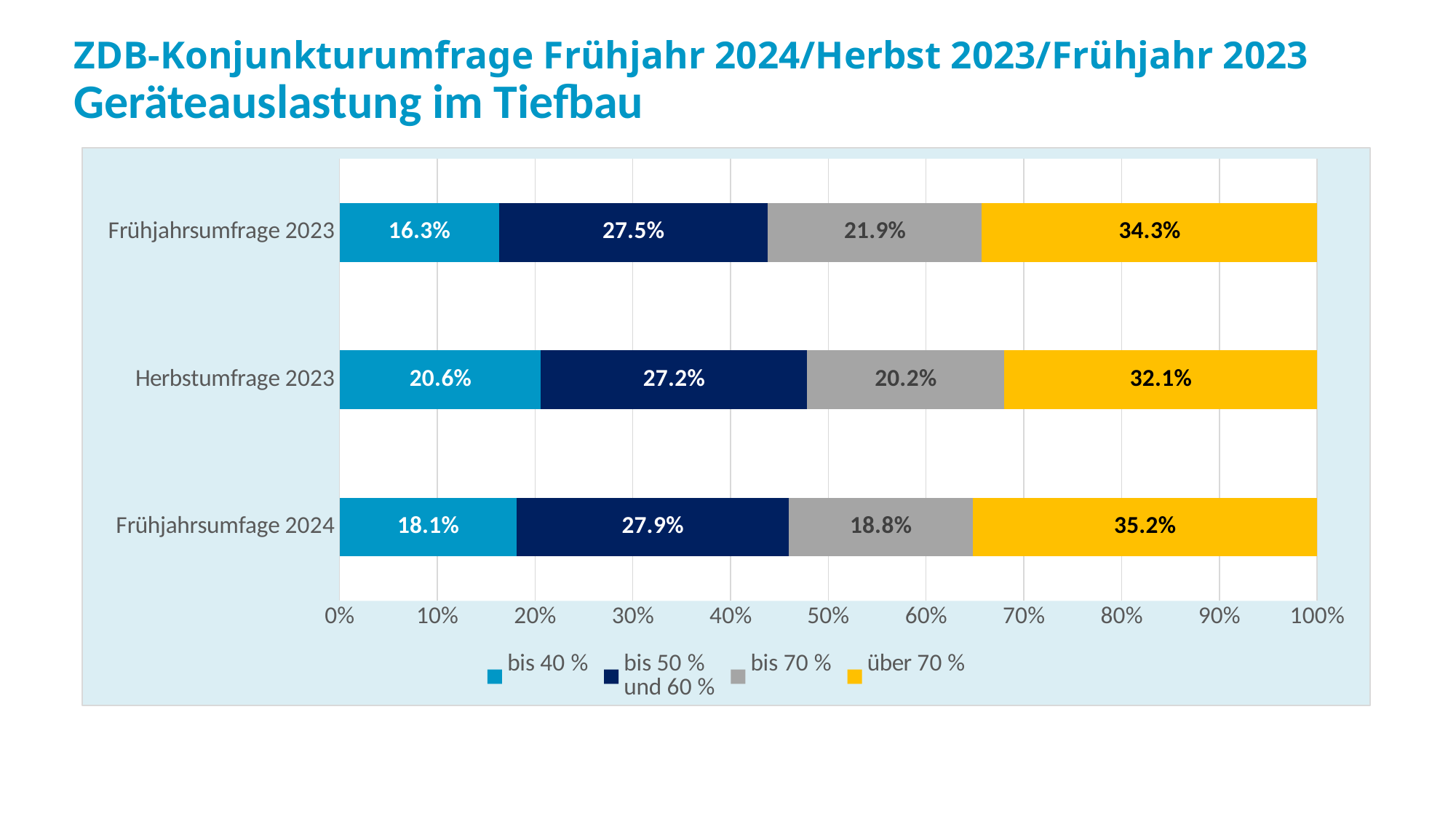
What is the difference between the 'über 70 %' values for Frühjahrsumfage 2024 and Herbstumfrage 2023? 3.1% Which survey has the lowest 'bis 40 %' share? Frühjahrsumfrage 2023 What is the value of the 'bis 40 %' segment for Herbstumfrage 2023? 20.6% Which survey has the highest 'über 70 %' share? Frühjahrsumfage 2024 How many series does the legend list? 4 What is the value of the 'bis 70 %' segment for Frühjahrsumfage 2024? 18.8% Which is larger: the 'bis 70 %' value for Frühjahrsumfrage 2023 or for Herbstumfrage 2023? Frühjahrsumfrage 2023 What is the value of the 'über 70 %' segment for Frühjahrsumfrage 2023? 34.3% What is the value of the 'bis 50 % und 60 %' segment for Herbstumfrage 2023? 27.2% How many surveys (bars) are shown in the chart? 3 What colour represents the 'über 70 %' series? Yellow What kind of chart is shown on the slide? Stacked bar chart